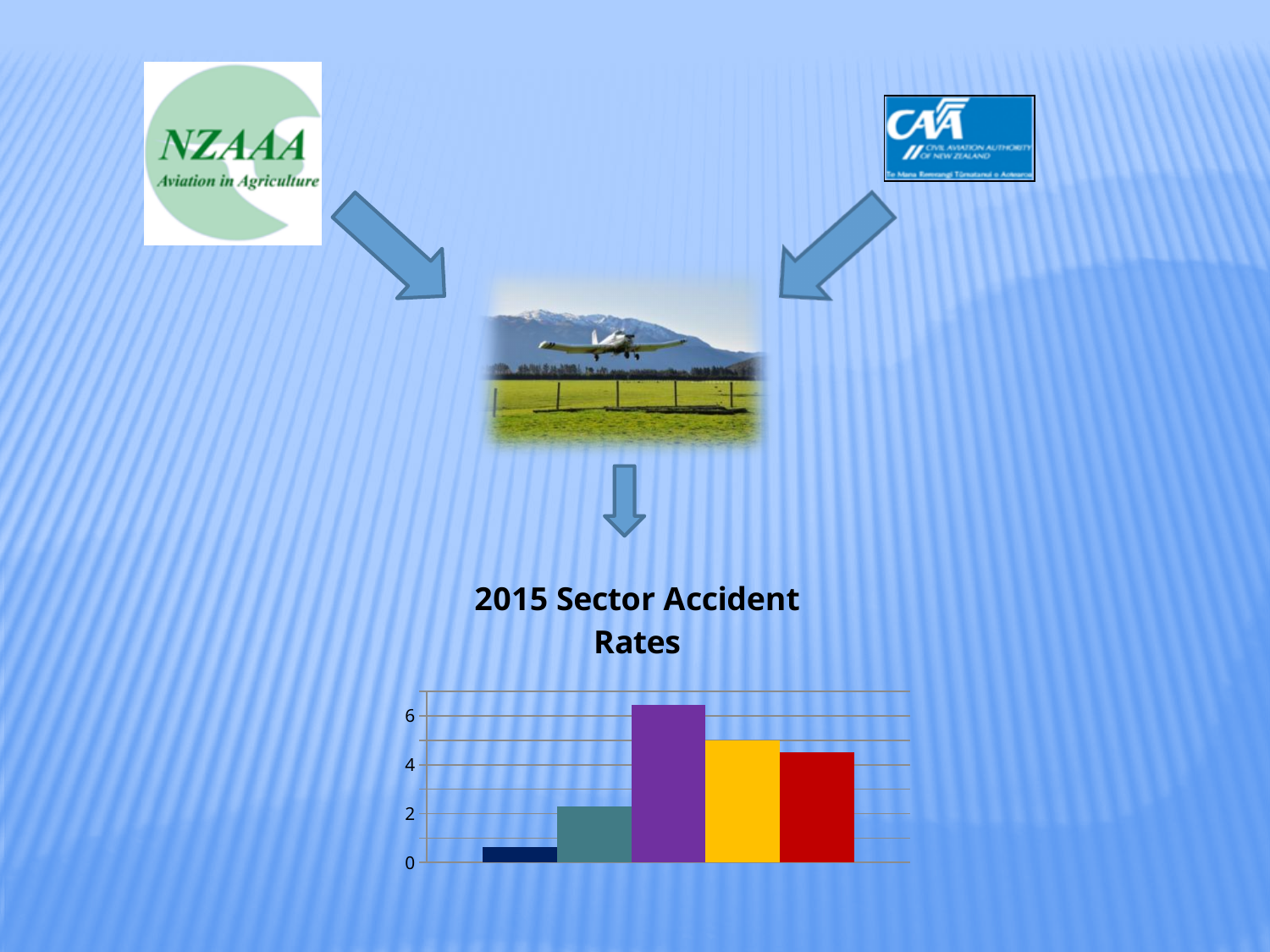
What is the highest value labelled on the vertical axis of the 2015 Sector Accident Rates chart? 6 How many bars are plotted in the 2015 Sector Accident Rates chart? 5 Which bar in the 2015 Sector Accident Rates chart is the shortest? the dark blue bar (first from left) What kind of chart is shown under the title '2015 Sector Accident Rates'? bar chart In the 2015 Sector Accident Rates chart, is the value of the dark blue bar greater or less than 2? less What is the title of the chart at the bottom of the slide? 2015 Sector Accident Rates In the 2015 Sector Accident Rates chart, is the value of the teal bar greater or less than 2? greater In the 2015 Sector Accident Rates chart, is the value of the red bar greater or less than 4? greater Which bar in the 2015 Sector Accident Rates chart is the tallest? the purple bar (third from left) In the 2015 Sector Accident Rates chart, which is larger, the purple bar or the yellow bar? the purple bar